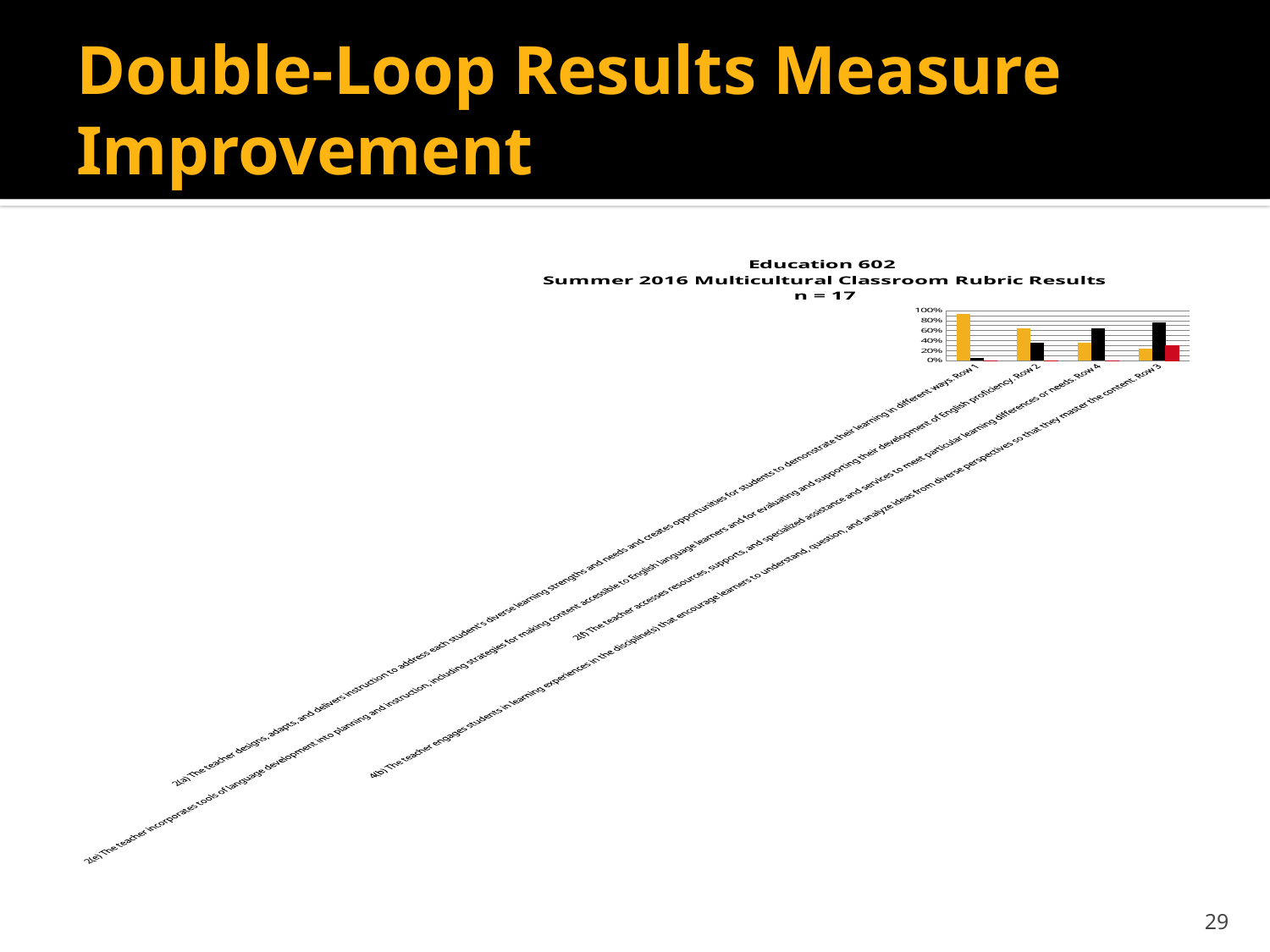
How many category groups are plotted along the x axis? 4 Is the black bar for the last category (4(b) ... Row 3) greater or less than 60%? greater What kind of chart is shown on the slide? Bar chart In the last category (4(b) ... Row 3), which is larger, the yellow bar or the black bar? The black bar What is the title of the chart? Education 602 Summer 2016 Multicultural Classroom Rubric Results n = 17 Do the yellow bars rise or fall moving from left to right across the categories? Fall Is the black bar for the third category (2(f) ... Row 4) greater or less than 40%? greater Is the yellow bar for the second category (2(e) ... Row 2) greater or less than 40%? greater What sample size (n) is stated in the chart title? 17 Which category has the tallest yellow bar? 2(a) ... Row 1